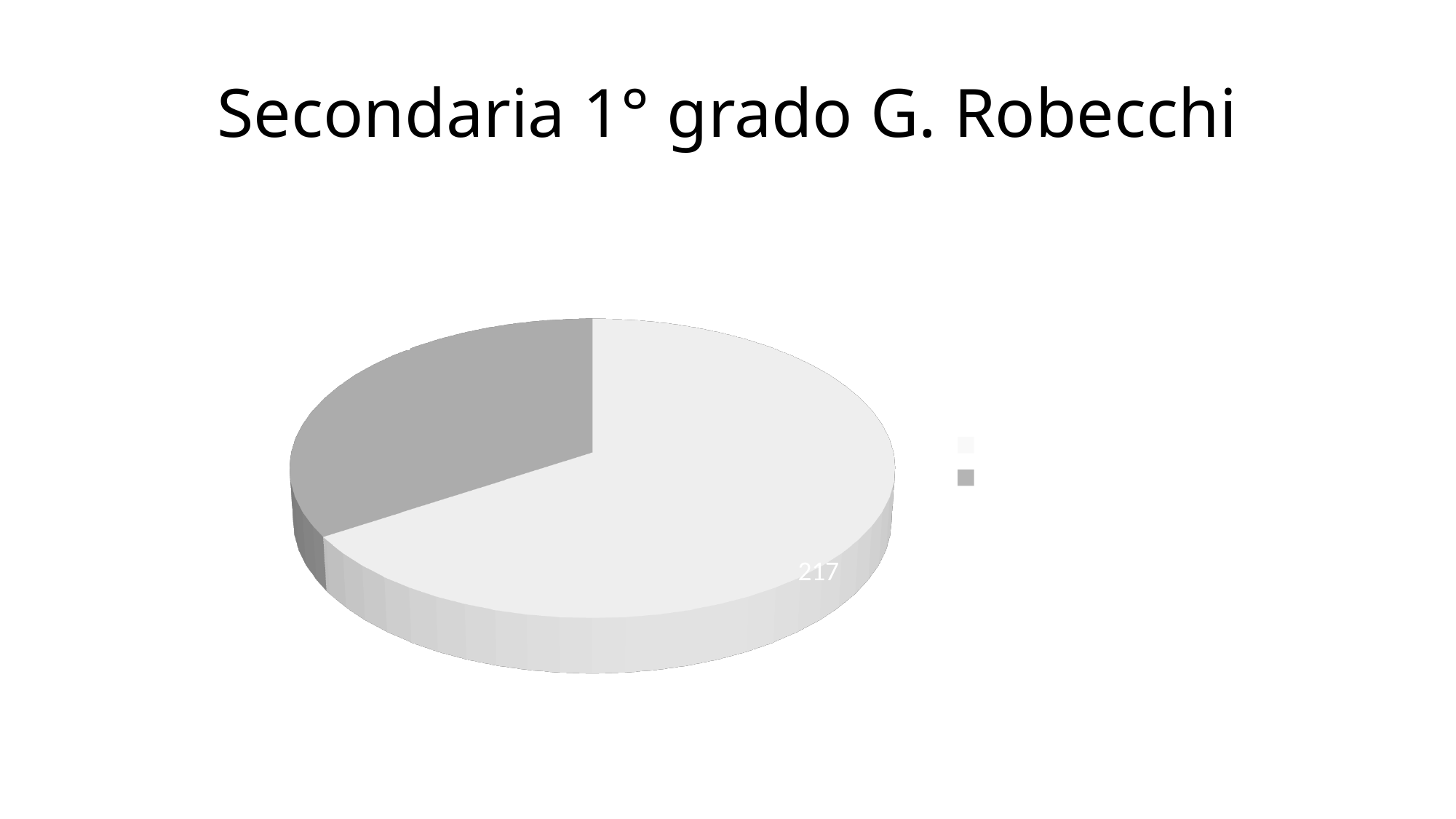
Which slice is larger, the light-coloured slice or the dark grey slice? the light-coloured slice How many entries does the legend list? 2 How many slices does the pie chart have? 2 What value is printed on the larger (light-coloured) slice of the pie chart? 217 Is the value of the light-coloured slice greater or less than 200? greater Which slice of the pie chart is the smallest? the dark grey slice What is the title of the chart on the slide? Secondaria 1° grado G. Robecchi What kind of chart is shown on the slide? pie chart